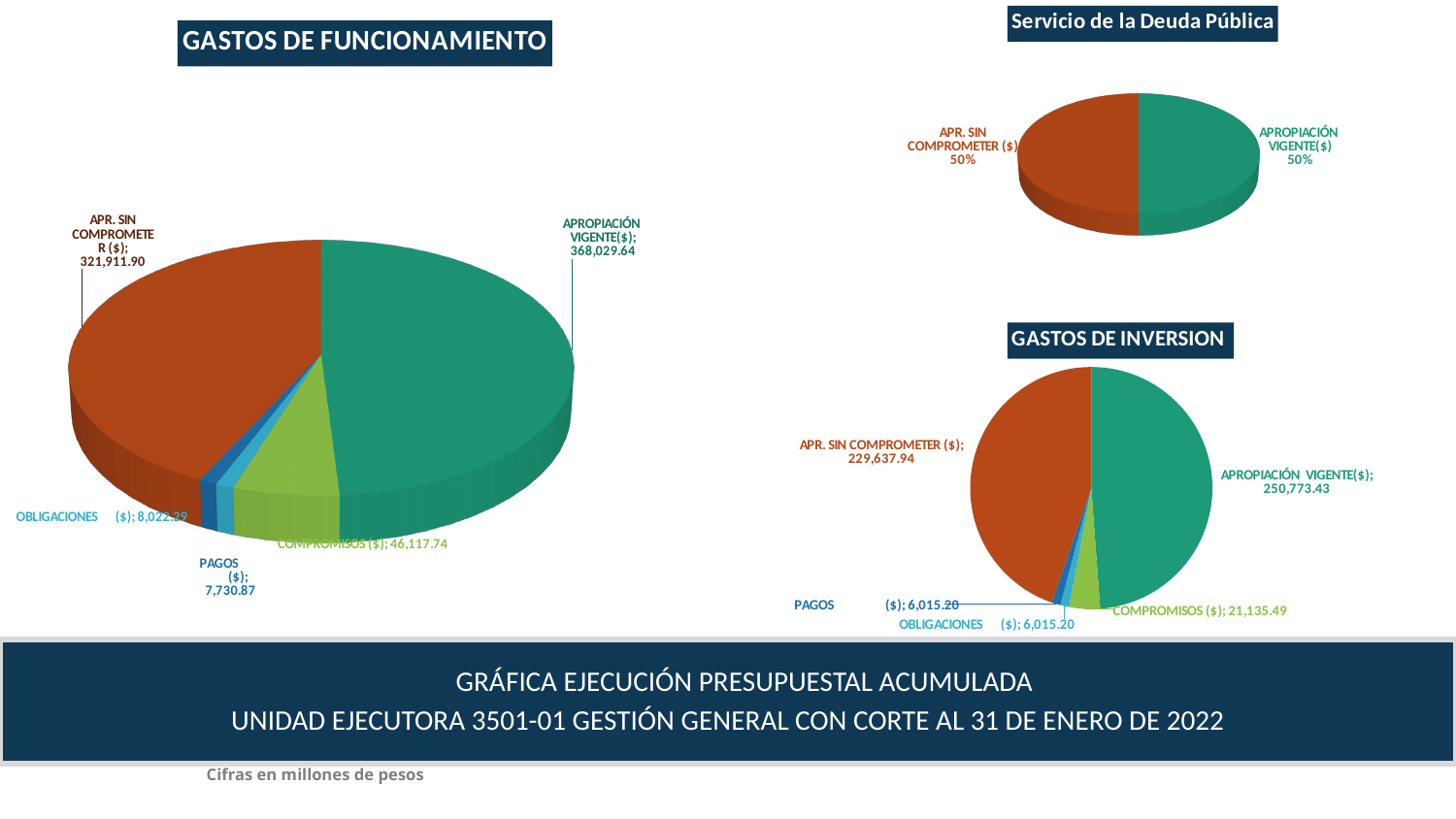
In the GASTOS DE INVERSION chart, which category has the largest value? APROPIACIÓN VIGENTE($) In the GASTOS DE INVERSION chart, what is the difference between APROPIACIÓN VIGENTE($) and APR. SIN COMPROMETER ($)? 21,135.49 What kind of chart is the Servicio de la Deuda Pública chart? Pie chart In the GASTOS DE INVERSION chart, which is larger, COMPROMISOS ($) or PAGOS ($)? COMPROMISOS ($) In the GASTOS DE FUNCIONAMIENTO chart, how many slices does the pie have? 5 In the GASTOS DE INVERSION chart, what is the value for APR. SIN COMPROMETER ($)? 229,637.94 In the GASTOS DE FUNCIONAMIENTO chart, what is the value for COMPROMISOS ($)? 46,117.74 How many pie charts are shown on the slide? 3 In the GASTOS DE FUNCIONAMIENTO chart, which category has the smallest value? PAGOS ($) In the Servicio de la Deuda Pública chart, what share of the pie is APR. SIN COMPROMETER ($)? 50% In the GASTOS DE FUNCIONAMIENTO chart, what is the difference between APROPIACIÓN VIGENTE($) and APR. SIN COMPROMETER ($)? 46,117.74 In the GASTOS DE FUNCIONAMIENTO chart, what is the value for APROPIACIÓN VIGENTE($)? 368,029.64